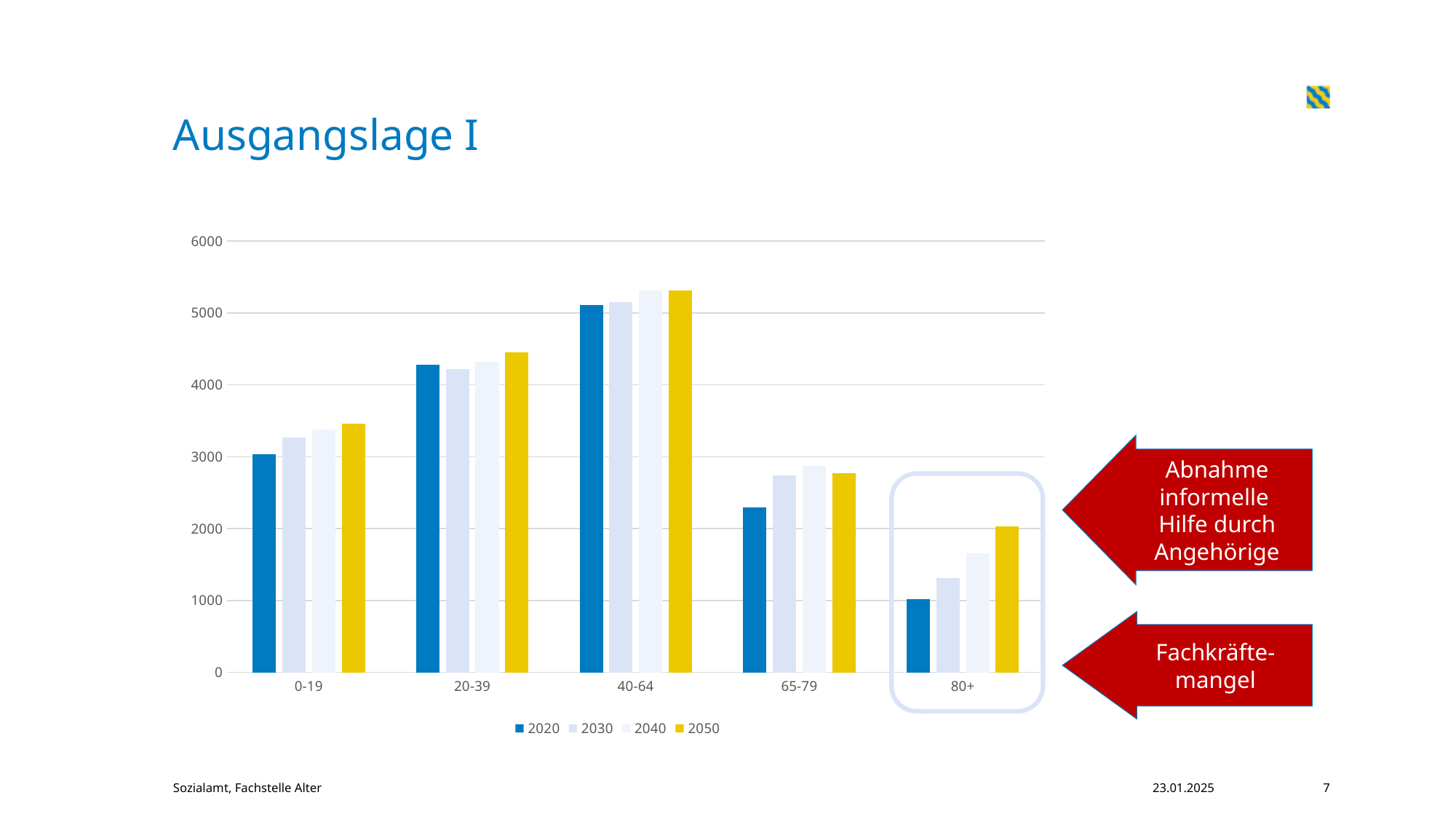
Is the 2050 value for the 0-19 category greater or less than 3000? greater Do the values for the 80+ category rise or fall from 2020 to 2050? rise Which age category has the highest value for the 2050 series? 40-64 How many series does the legend list? 4 Is the 2040 value for the 80+ category greater or less than 2000? less For the 80+ category, which is larger: the 2020 value or the 2050 value? 2050 How many age categories are shown on the x axis? 5 Is the 2050 value for the 40-64 category greater or less than 5000? greater Which series is shown in yellow in the legend? 2050 What kind of chart is shown on the slide? bar chart Which age category has the lowest value for the 2020 series? 80+